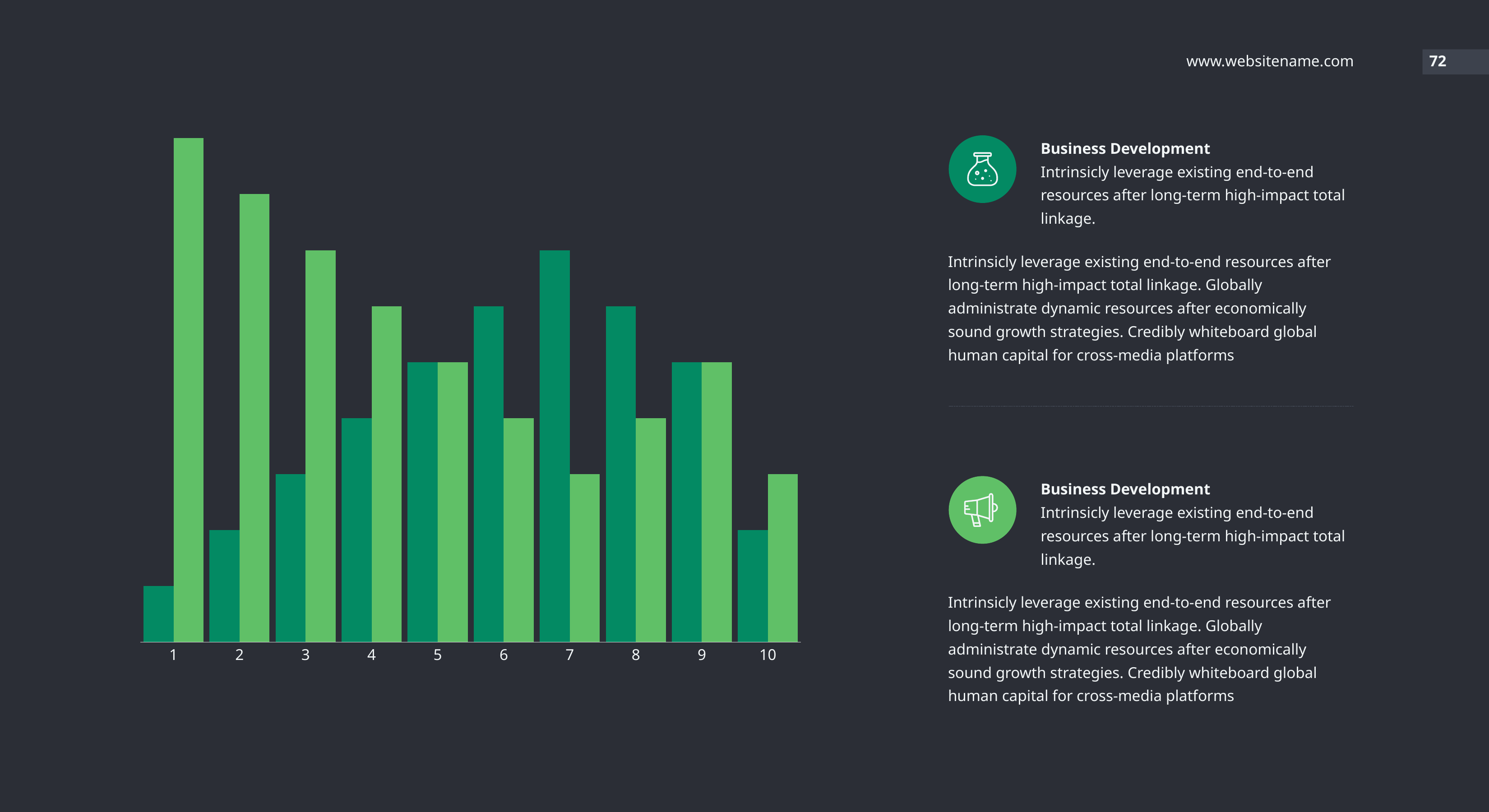
What kind of chart is shown on the slide? bar chart In category 7, which bar is taller, the dark green or the light green one? dark green How many categories are shown on the x axis of the chart? 10 Do the light green bars rise or fall from category 1 to category 4? fall Which category has the tallest light green bar? 1 Which category has the shortest dark green bar? 1 In category 2, which bar is taller, the dark green or the light green one? light green Is the dark green bar for category 7 taller or shorter than the dark green bar for category 2? taller Which category has the tallest dark green bar? 7 How many different bar colours are used in the chart? 2